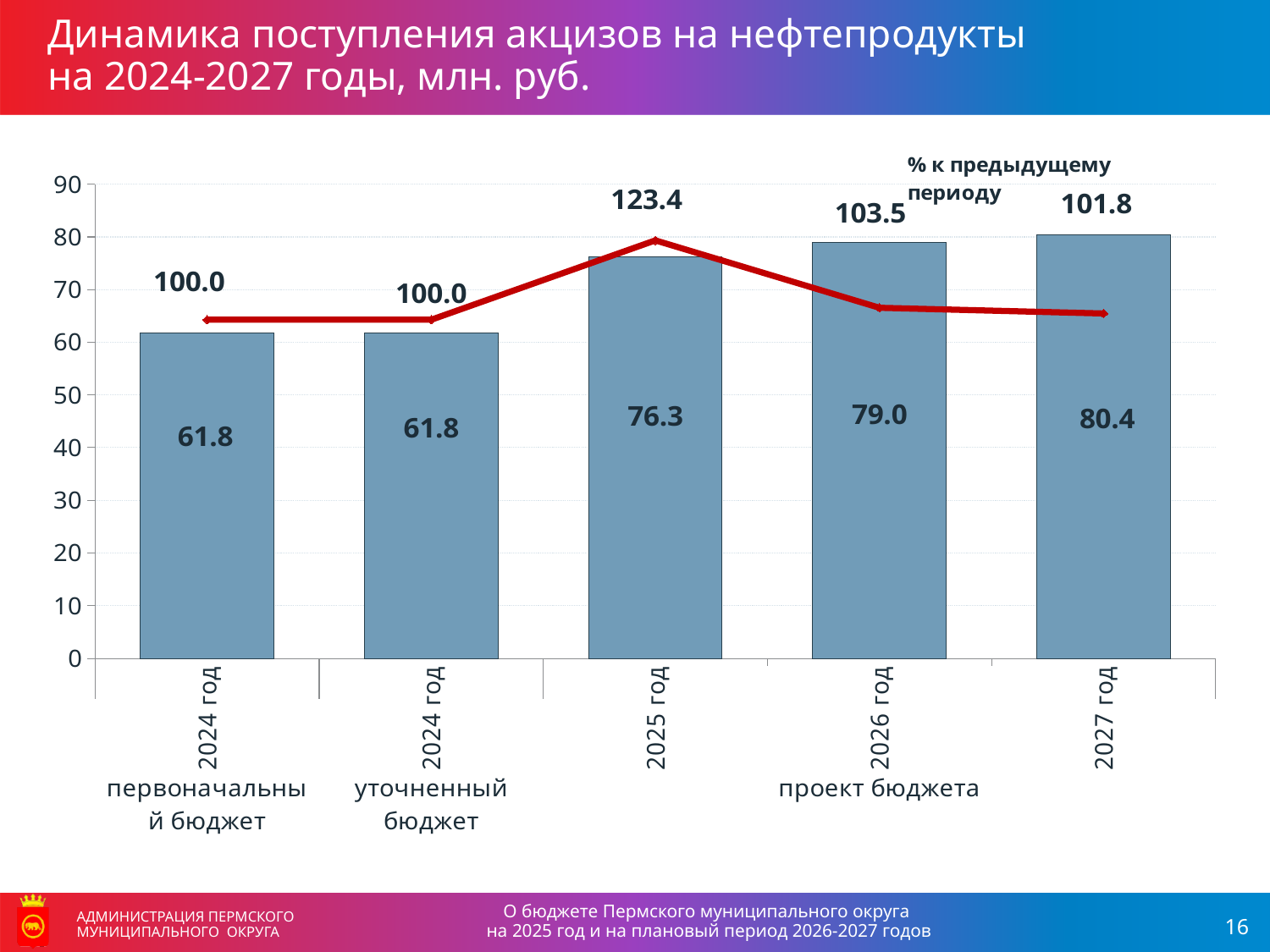
What is the difference between the bar values for 2025 год and 2024 год (уточненный бюджет)? 14.5 What is the difference between the bar values for 2027 год and 2026 год? 1.4 What is the value of the bar for 2027 год? 80.4 Which year has the highest bar value? 2027 год What is the '% к предыдущему периоду' value shown for 2026 год? 103.5 What is the excise revenue value shown for 2025 год? 76.3 Which is larger: the bar value for 2026 год or for 2025 год? 2026 год Do the bar values rise or fall from 2025 год to 2027 год? rise How many bars are plotted on the chart? 5 What is the '% к предыдущему периоду' value shown for 2025 год? 123.4 Which year has the highest '% к предыдущему периоду' value? 2025 год What is the title of the chart on the slide? Динамика поступления акцизов на нефтепродукты на 2024-2027 годы, млн. руб.